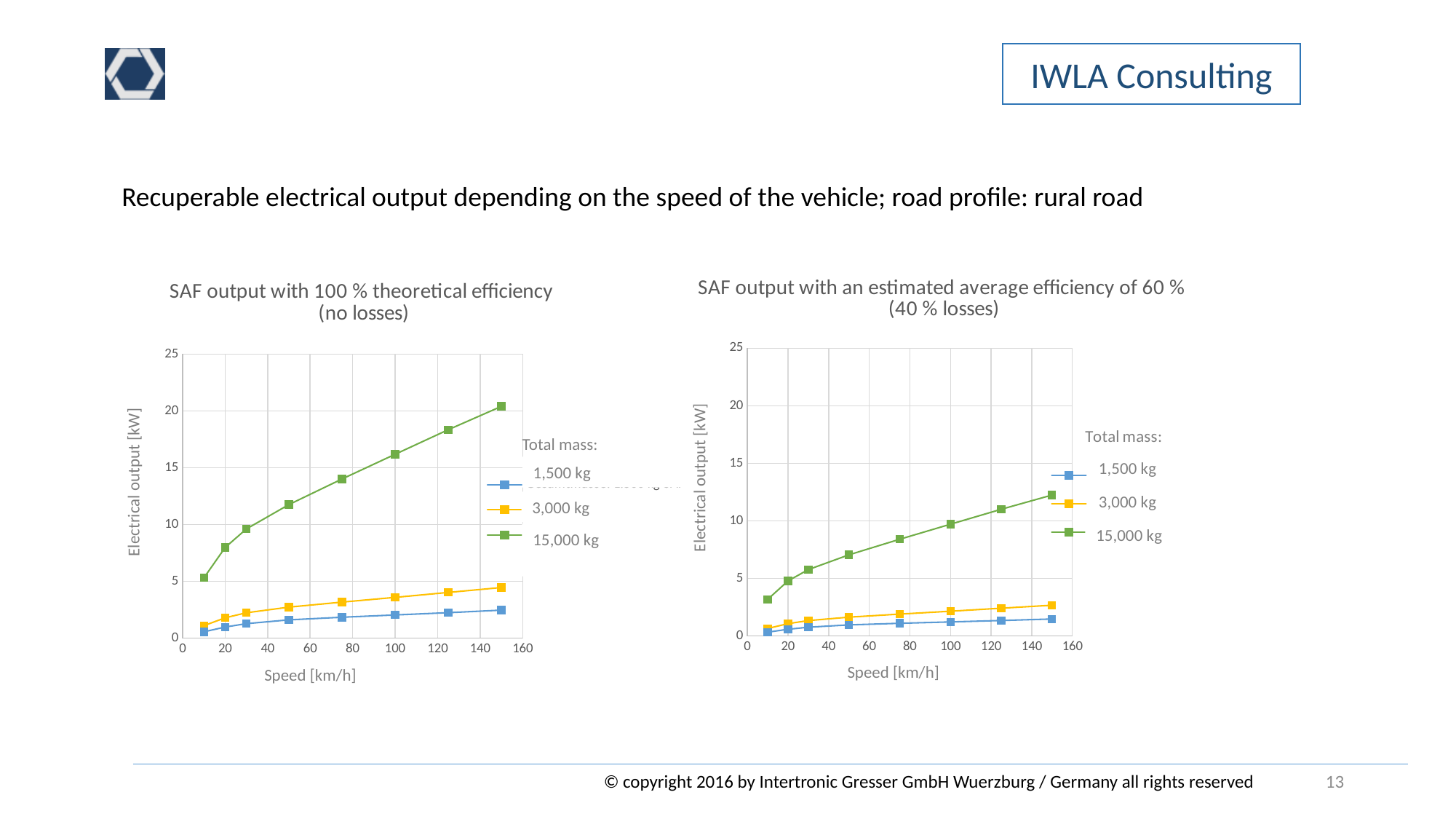
In the right chart (60 % efficiency), is the electrical output for 3,000 kg at 150 km/h greater or less than 5 kW? less What is the label of the x axis on the left chart? Speed [km/h] In the left chart (100 % theoretical efficiency), which total mass series has the highest electrical output at 150 km/h? 15,000 kg In the right chart (60 % efficiency), is the electrical output for 15,000 kg at 150 km/h greater or less than 10 kW? greater In the left chart (100 % theoretical efficiency), which is larger at 150 km/h: the output for 3,000 kg or for 1,500 kg? 3,000 kg In the left chart (100 % theoretical efficiency), is the electrical output for 15,000 kg at 100 km/h greater or less than 15 kW? greater How many series does the legend of the right chart, 'SAF output with an estimated average efficiency of 60 %', list? 3 In the right chart (60 % efficiency), which total mass series has the lowest electrical output at 150 km/h? 1,500 kg In the left chart (100 % theoretical efficiency), how many data points are plotted for the 15,000 kg series? 8 What type of chart is the left chart, 'SAF output with 100 % theoretical efficiency (no losses)'? line chart In the right chart (60 % efficiency), does the electrical output for the 15,000 kg series rise or fall as speed increases? rise